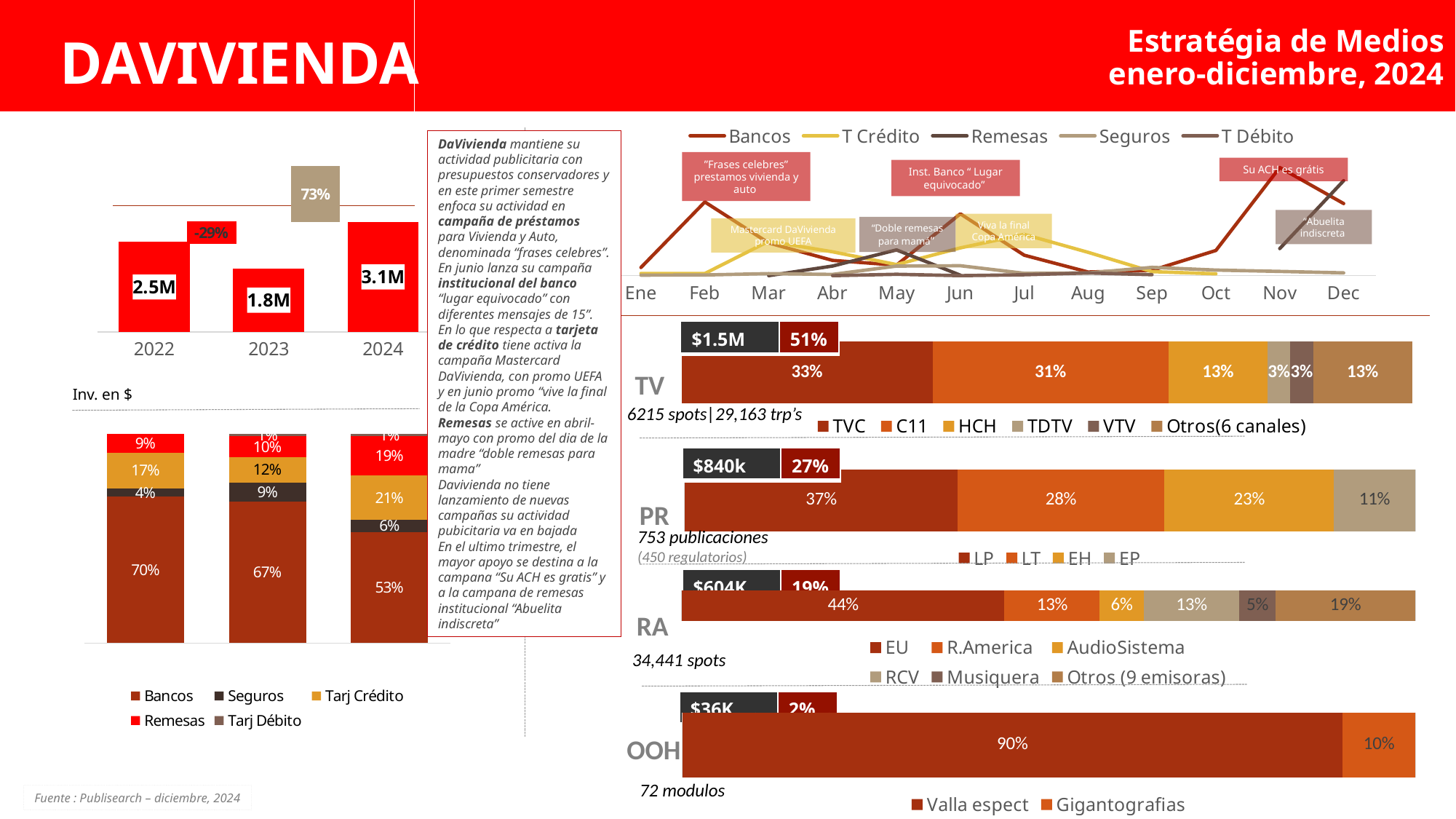
In the 'Inv. en $' bar chart at the top left, what is the value for 2024? 3.1M In the OOH bar on the right, what share does Gigantografias have? 10% What kind of chart is the chart at the top right showing Bancos, T Crédito, Remesas, Seguros and T Débito by month? line chart In the stacked bar chart at the bottom left, what share does Bancos have in 2024? 53% In the stacked bar chart at the bottom left, how many series does the legend list? 5 In the TV bar on the right, what share does C11 have? 31% In the line chart at the top right, how many months are shown on the x axis? 12 In the RA bar on the right, which is larger, the share for EU or the share for Otros (9 emisoras)? EU In the 'Inv. en $' bar chart at the top left, what is the difference between the 2024 and 2022 values? 0.6M In the stacked bar chart at the bottom left, does the Bancos share rise or fall from 2022 to 2024? fall In the PR bar on the right, which outlet has the largest share? LP In the 'Inv. en $' bar chart at the top left, which year has the lowest investment? 2023